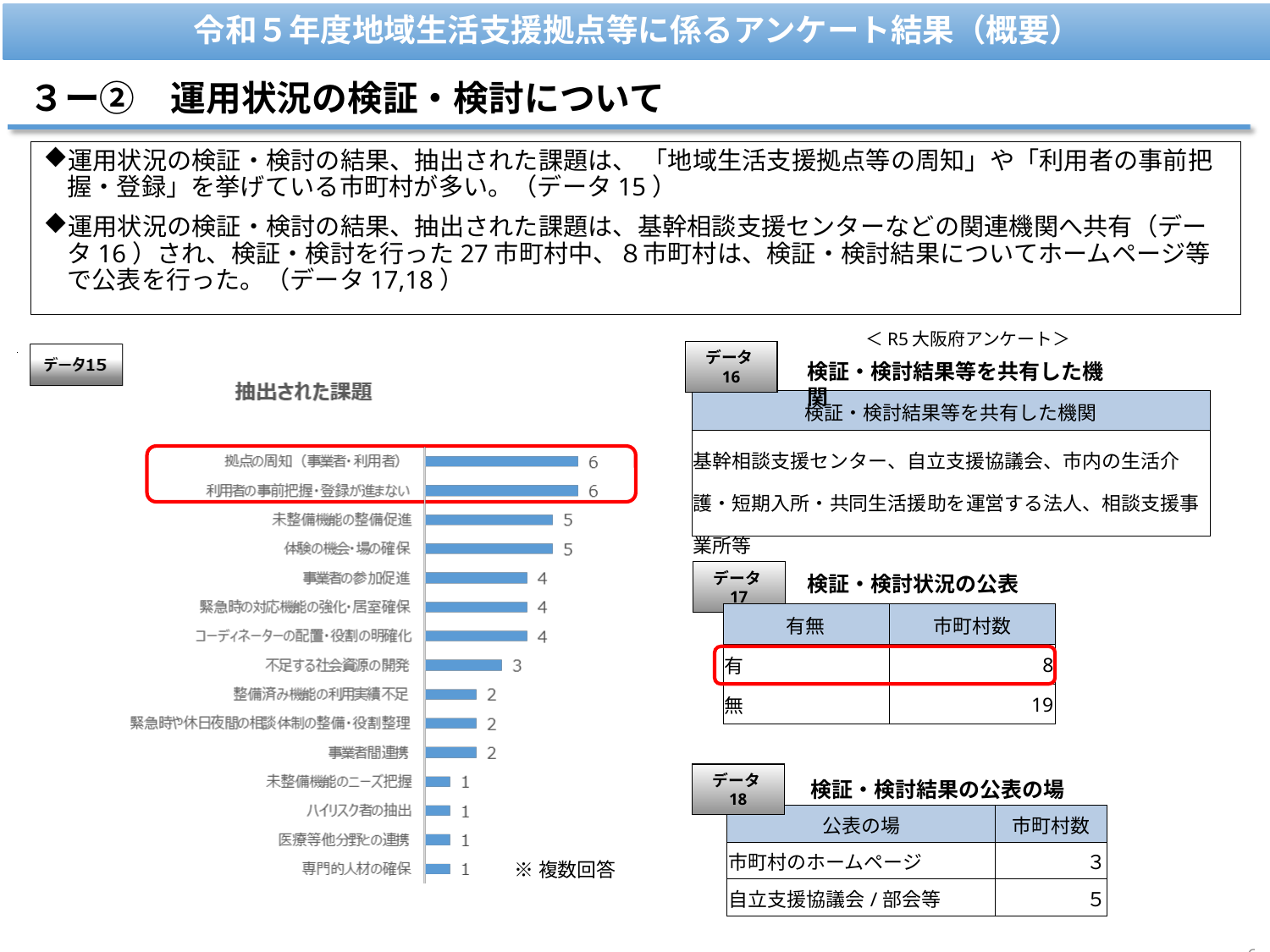
What type of chart is used to show 抽出された課題? bar chart In the 抽出された課題 chart, what is the value for 専門的人材の確保? 1 In the 抽出された課題 chart, what is the highest value shown? 6 In the 抽出された課題 chart, what is the difference between 利用者の事前把握・登録が進まない and 事業者の参加促進? 2 In the 抽出された課題 chart, do the values rise or fall going from the top category to the bottom category? fall In the 抽出された課題 chart, what is the lowest value shown? 1 In the 抽出された課題 chart, what is the value for 不足する社会資源の開発? 3 In the 抽出された課題 chart, what is the value for 事業者間連携? 2 How many categories are shown in the 抽出された課題 chart? 15 In the 抽出された課題 chart, what is the value for 拠点の周知（事業者・利用者）? 6 What is the title of the chart on the left of the slide? 抽出された課題 In the 抽出された課題 chart, which is larger: 体験の機会・場の確保 or 整備済み機能の利用実績不足? 体験の機会・場の確保